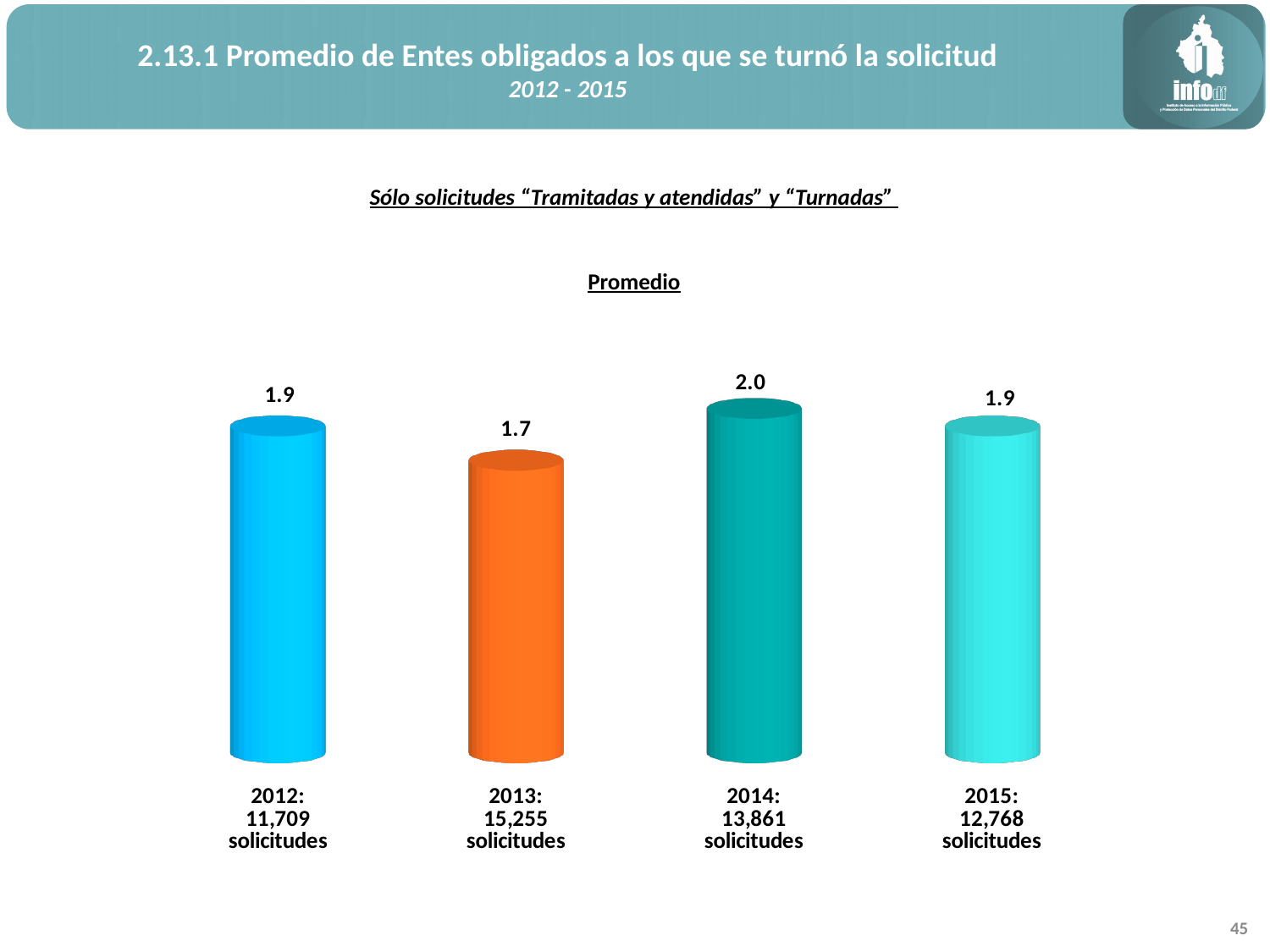
What is the average value shown for 2014? 2.0 How many years (categories) are shown in the chart? 4 What is the average (Promedio) value shown for 2012? 1.9 How many solicitudes are listed in the category label for 2013? 15,255 Which year has the lowest average value? 2013 What is the average value shown for 2013? 1.7 What is the title shown above the chart? Promedio Which is larger, the average value for 2013 or for 2014? 2014 What kind of chart is shown on the slide? Bar chart What is the difference between the average values for 2014 and 2013? 0.3 What is the average value shown for 2015? 1.9 Which year has the highest average value? 2014